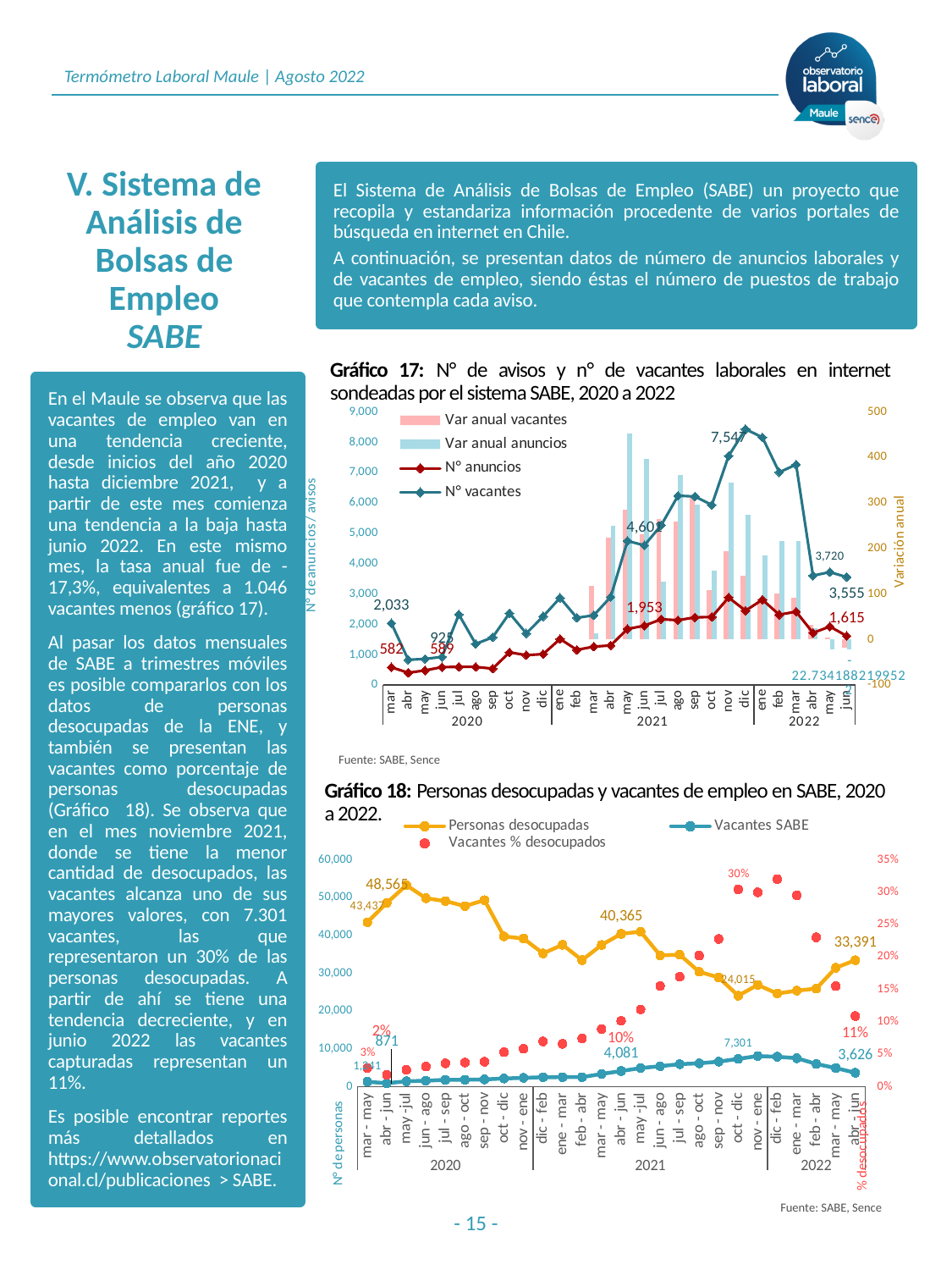
In Gráfico 18, what is the labelled peak value of Vacantes SABE? 7,301 In Gráfico 17, what is the difference between the N° vacantes value in November 2021 (7,547) and in June 2022 (3,555)? 3,992 In Gráfico 17, what is the labelled value of N° anuncios in June 2022? 1,615 In Gráfico 18, what is the labelled Vacantes % desocupados value for abr - jun 2022? 11% In Gráfico 17, what is the labelled value of N° vacantes in June 2022? 3,555 In Gráfico 17, what is the labelled value of N° vacantes in November 2021? 7,547 In Gráfico 17, how many series does the legend list? 4 In Gráfico 17, in June 2022, which is larger: N° vacantes or N° anuncios? N° vacantes In Gráfico 18, what is the highest labelled value of Personas desocupadas? 48,565 In Gráfico 18, how many series does the legend list? 3 In Gráfico 17, what is the labelled value of N° vacantes in March 2020? 2,033 In Gráfico 18, what is the labelled value of Personas desocupadas for abr - jun 2022? 33,391